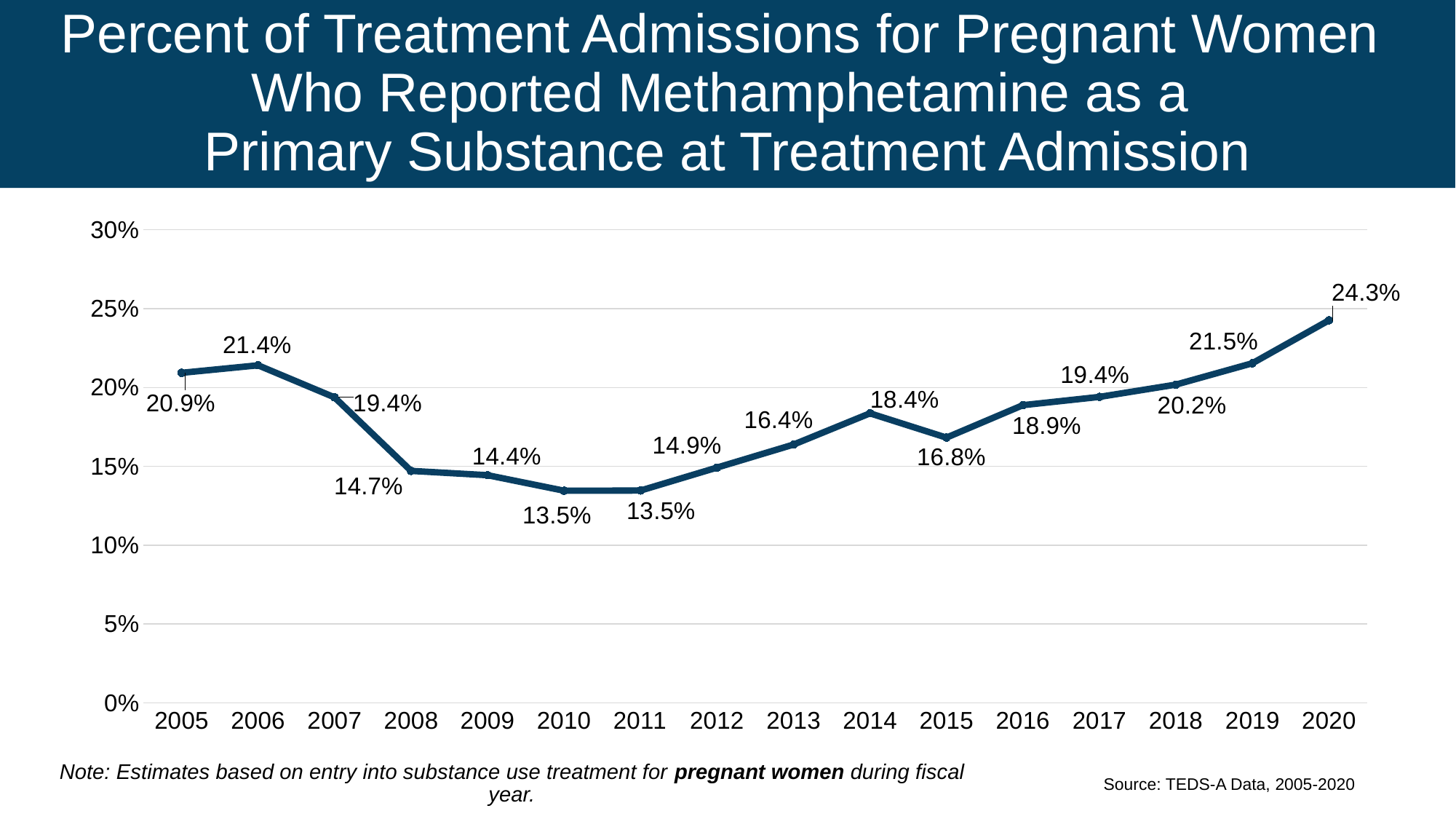
How many years are plotted on the chart? 16 How many percentage points higher is the 2020 value than the 2005 value? 3.4 percentage points By how many percentage points did the value fall from 2006 to 2007? 2.0 percentage points What value is shown for 2015? 16.8% Which year has the larger value, 2014 or 2015? 2014 What is the lowest percentage value shown on the chart? 13.5% Which year has the highest percentage on the chart? 2020 Is the value for 2010 greater or less than 15%? less Do the values rise or fall from 2016 to 2020? Rise What value is shown for 2008? 14.7% What kind of chart is shown on the slide? Line chart What was the percent of treatment admissions for pregnant women reporting methamphetamine as a primary substance in 2020? 24.3%